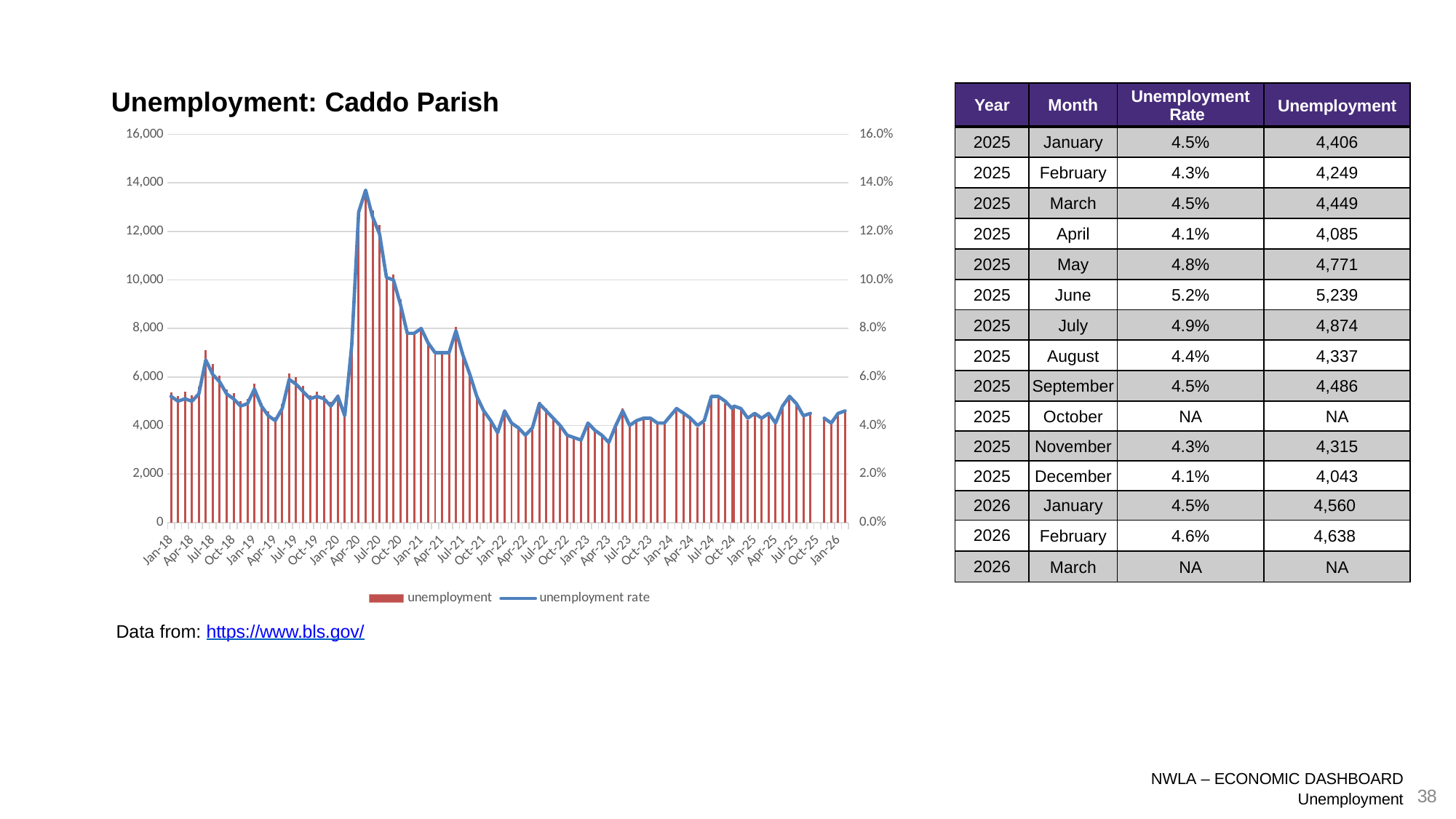
Is the peak unemployment bar around Apr-20 greater or less than 12,000? greater According to the table, what was the unemployment count in January 2026? 4,560 What is the difference in unemployment between January 2026 (4,560) and December 2025 (4,043)? 517 Around which x-axis label does unemployment reach its highest point? Apr-20 How many series does the chart legend list? 2 Does unemployment rise or fall between Apr-20 and Jan-22? Fall What are the two series named in the chart legend? unemployment and unemployment rate Is the unemployment rate at Jan-18 greater or less than 6.0%? less What kind of chart is shown on the slide? A combined bar and line chart What is the title of the chart? Unemployment: Caddo Parish According to the table, what was the unemployment rate in June 2025? 5.2% Which month in the table has the lowest unemployment count? December 2025